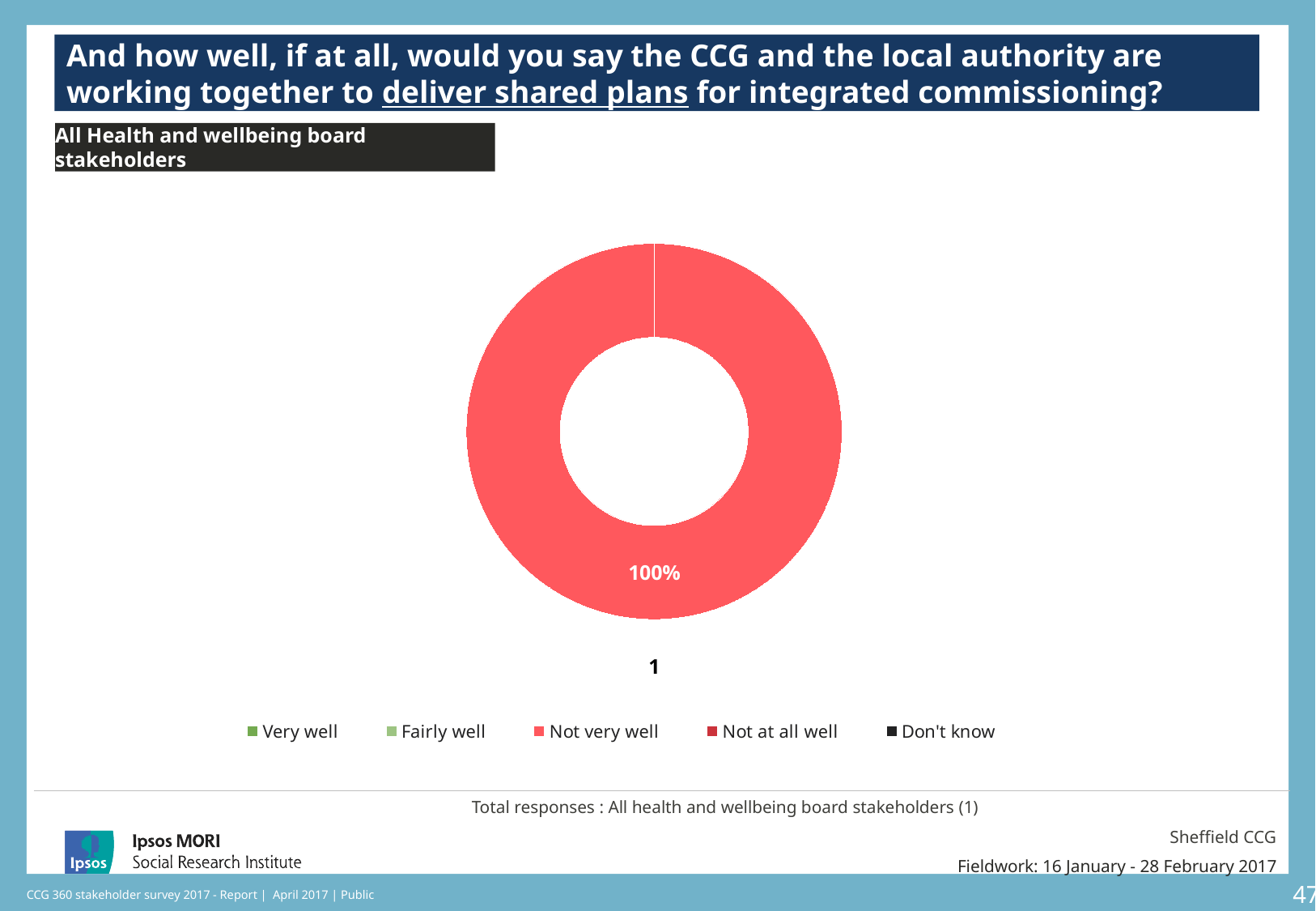
What kind of chart is shown on the slide? doughnut chart How many slices are visible in the doughnut chart? 1 Which legend category does the only slice in the doughnut chart belong to? Not very well What percentage is printed on the single slice of the doughnut chart? 100% What share of the doughnut does the 'Not very well' slice take up? 100% What label is printed directly beneath the doughnut chart? 1 Which legend entry is shown with a black marker? Don't know Does the 'Very well' category have any visible slice in the doughnut chart? No How many entries does the chart legend list? 5 Is the value shown on the doughnut slice greater or less than 50%? greater